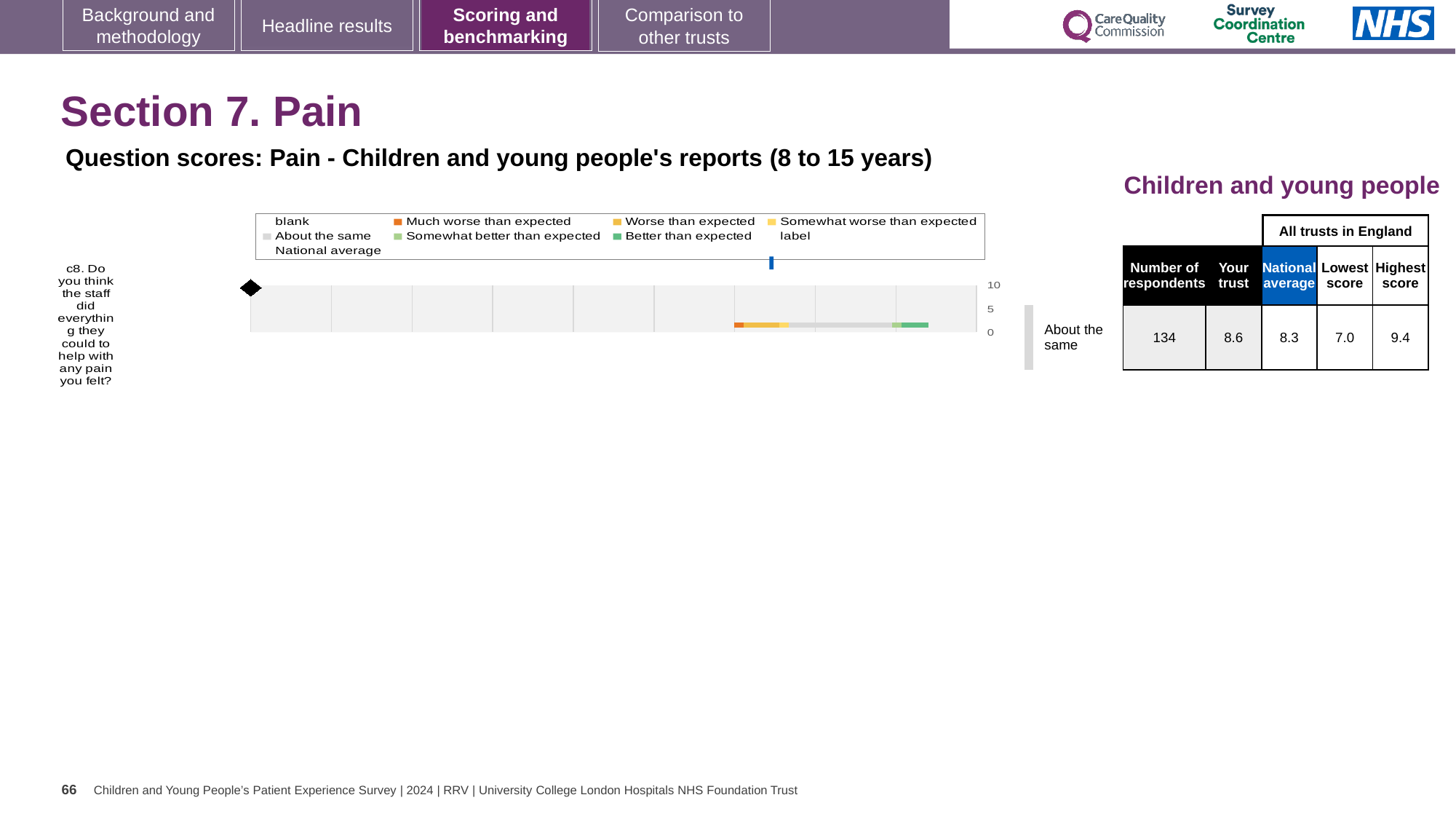
According to the table beside the chart, what is the score for Your trust on question c8? 8.6 According to the table beside the chart, what is the Lowest score among all trusts in England for question c8? 7.0 How many entries does the chart's legend list? 9 According to the table beside the chart, what is the Highest score among all trusts in England for question c8? 9.4 What kind of chart is shown on the slide? bar chart How many questions (categories) are plotted in the chart? 1 According to the table beside the chart, how many respondents answered question c8? 134 What benchmark category label is shown next to the chart for question c8? About the same Which is larger for question c8: the Your trust score or the National average score? Your trust According to the table beside the chart, what is the National average score for question c8? 8.3 Which legend entry is shown in orange? Much worse than expected What is the difference between the Highest score and the Lowest score for question c8? 2.4